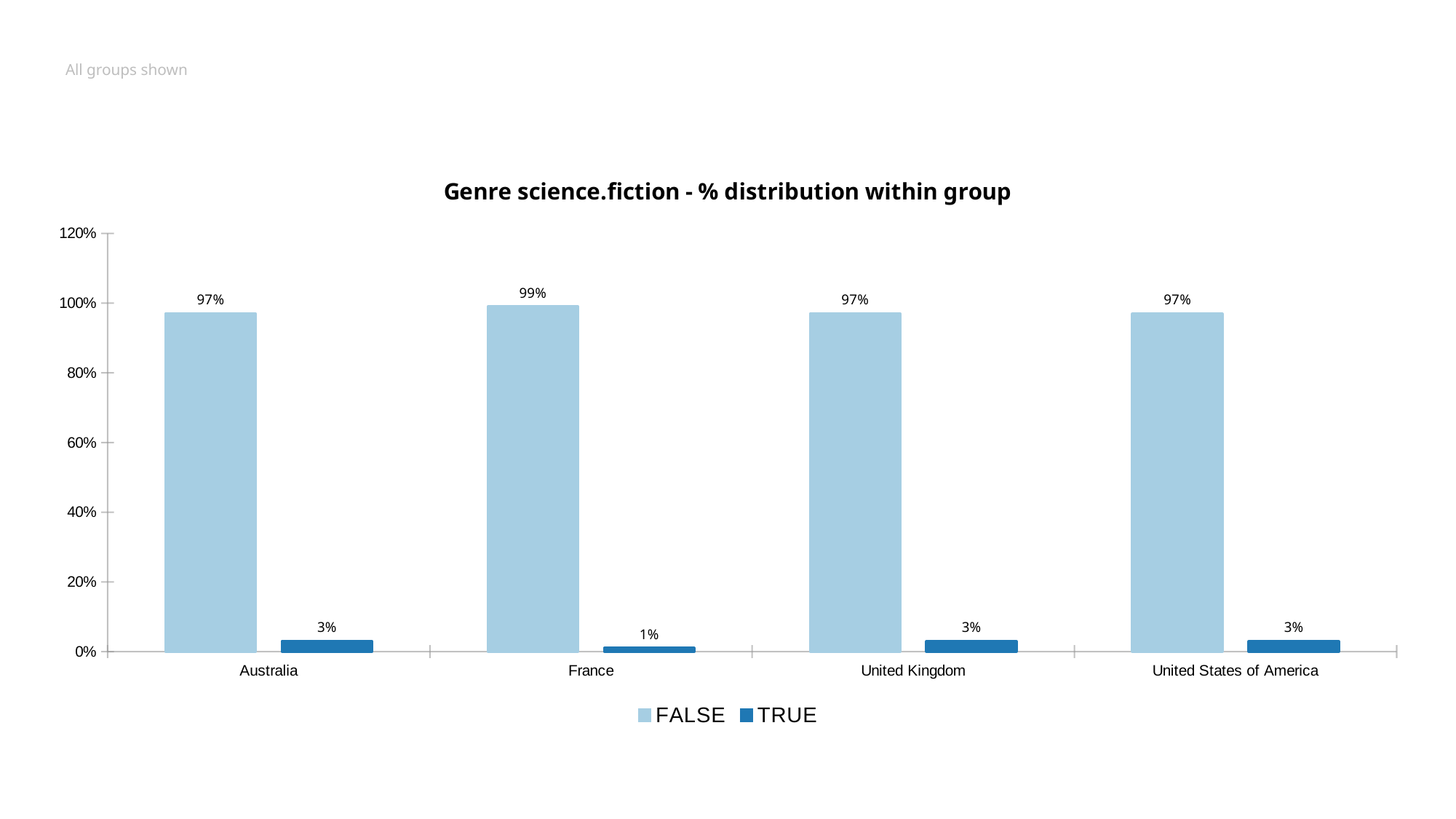
What is the title of the chart? Genre science.fiction - % distribution within group Which category has the highest FALSE value? France What is the difference between the FALSE and TRUE values for United States of America? 94% What is the TRUE value for Australia? 3% What is the FALSE value for France? 99% What is the TRUE value for France? 1% Which category has the lowest TRUE value? France Which is larger, the TRUE value for Australia or the TRUE value for France? Australia What is the FALSE value for United Kingdom? 97% What kind of chart is shown? bar chart How many series does the legend list? 2 How many categories are shown on the x axis? 4